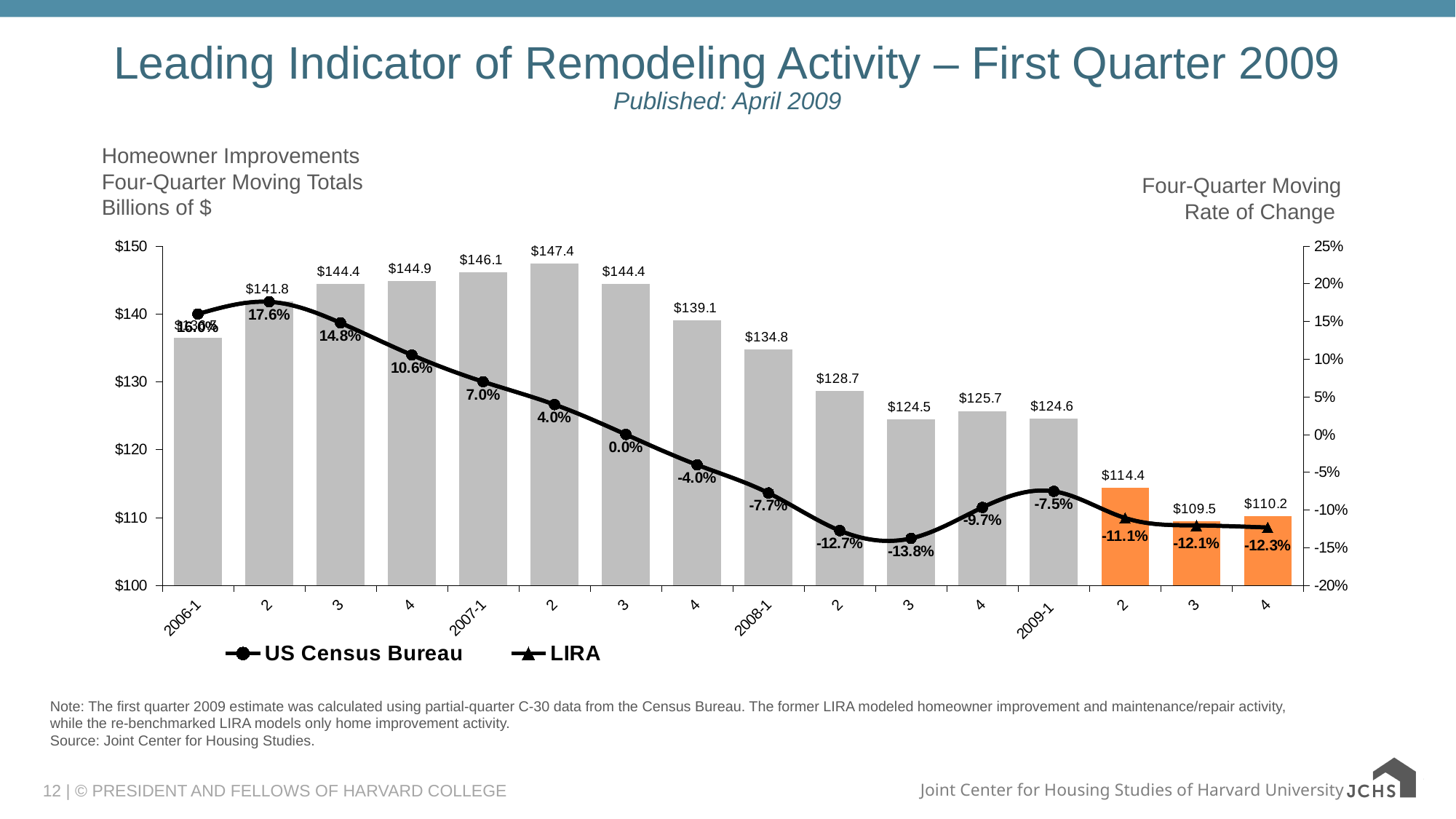
Is the homeowner improvements total for 2006-1 greater or less than $140? less Which quarter has the lowest homeowner improvements four-quarter moving total? 2009-3 What is the homeowner improvements four-quarter moving total for 2007-2? $147.4 How many quarters (bars) are plotted on the chart? 16 Which quarter has the highest homeowner improvements four-quarter moving total? 2007-2 What is the four-quarter moving rate of change shown for 2008-3? -13.8% What is the overall trend of the four-quarter moving rate of change from 2006-2 to 2008-3? falling How many series does the legend list? 2 What is the homeowner improvements value for the 2009-4 bar? $110.2 Which quarter has the highest four-quarter moving rate of change? 2006-2 What is the difference between the homeowner improvements totals for 2007-2 and 2009-3? $37.9 Which is larger, the homeowner improvements total for 2007-4 or for 2008-1? 2007-4